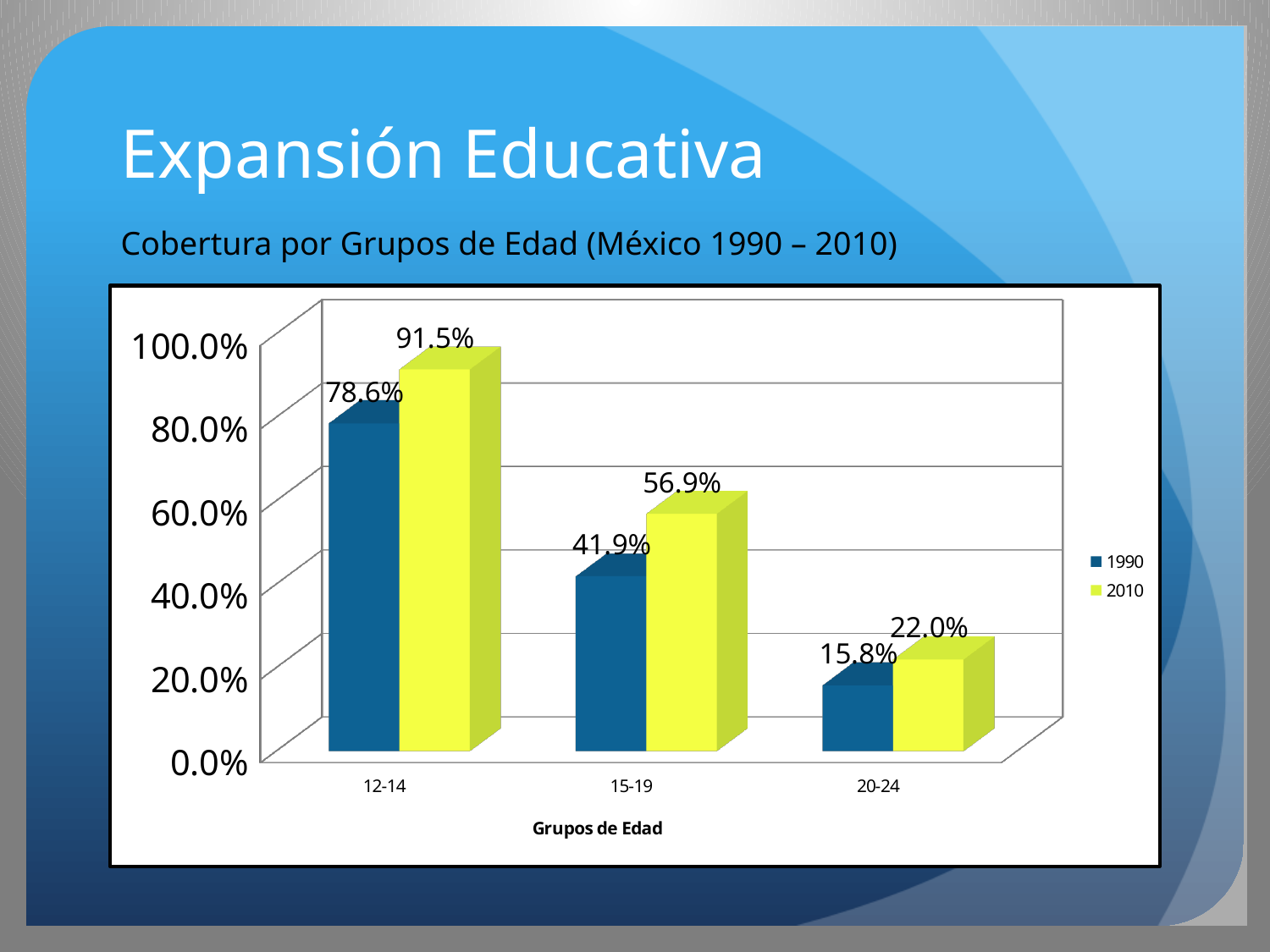
What kind of chart is shown on the slide? bar chart Which age group has the highest value in 2010? 12-14 Is the 2010 value for the 12-14 age group greater or less than 80.0%? greater What is the value for the 12-14 age group in 1990? 78.6% What is the value for the 15-19 age group in 2010? 56.9% How many age groups are shown on the x axis? 3 How many series does the legend list? 2 Which is larger for the 20-24 age group, the 1990 value or the 2010 value? 2010 What is the value for the 20-24 age group in 1990? 15.8% What is the difference between the 2010 and 1990 values for the 15-19 age group? 15.0% What is the x-axis title of the chart? Grupos de Edad Which age group has the lowest value in 1990? 20-24